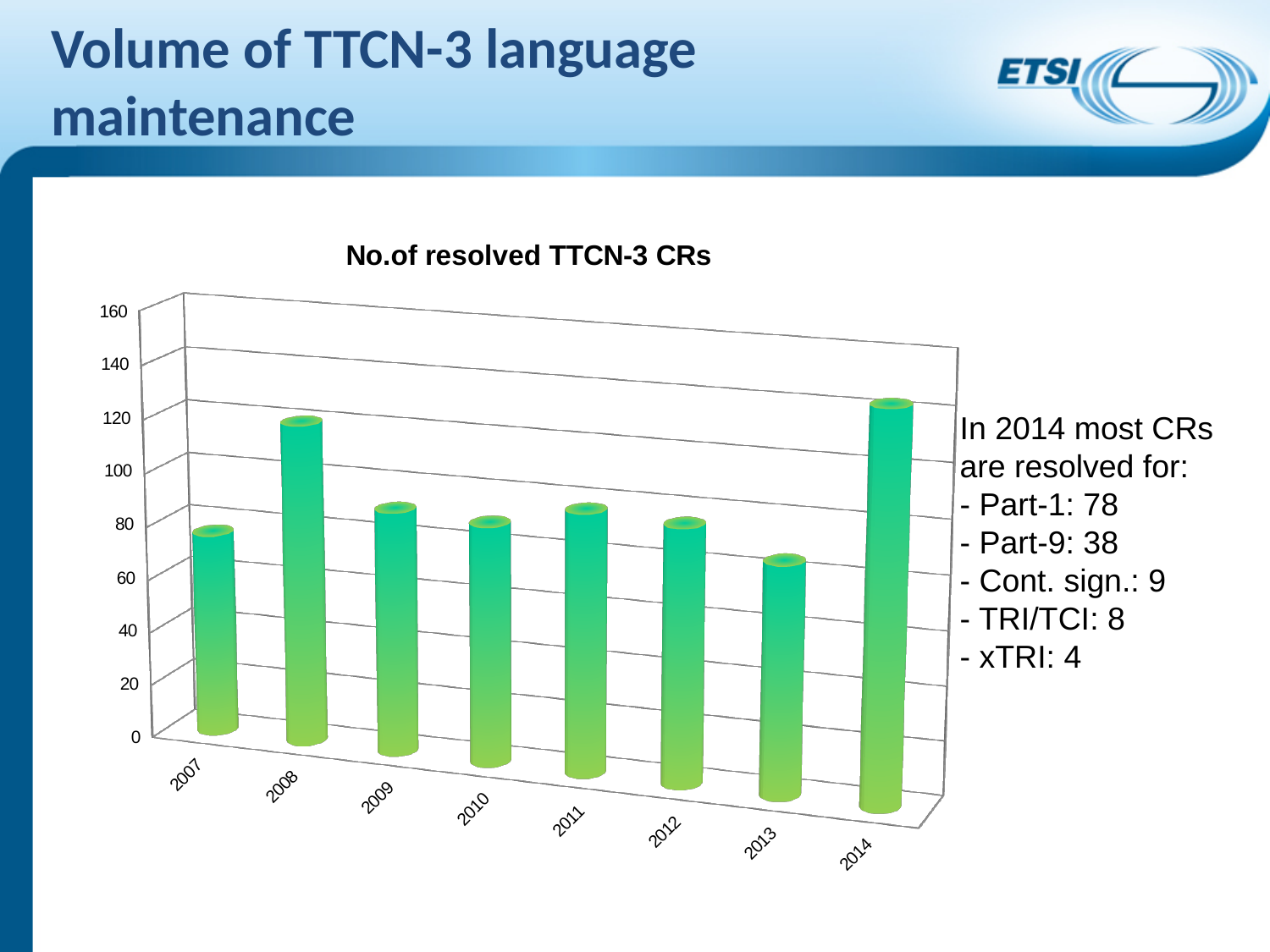
How many years are shown on the x axis of the chart? 8 Is the value for 2007 greater or less than 100? less Which year has the lowest number of resolved TTCN-3 CRs? 2007 What type of chart is shown on the slide? bar chart Is the value for 2008 greater or less than 100? greater What is the title of the chart? No.of resolved TTCN-3 CRs Is the value for 2014 greater or less than 120? greater Which year has more resolved CRs, 2008 or 2007? 2008 Does the number of resolved CRs rise or fall from 2013 to 2014? rise Which year has the highest number of resolved TTCN-3 CRs? 2014 Which year has more resolved CRs, 2012 or 2013? 2012